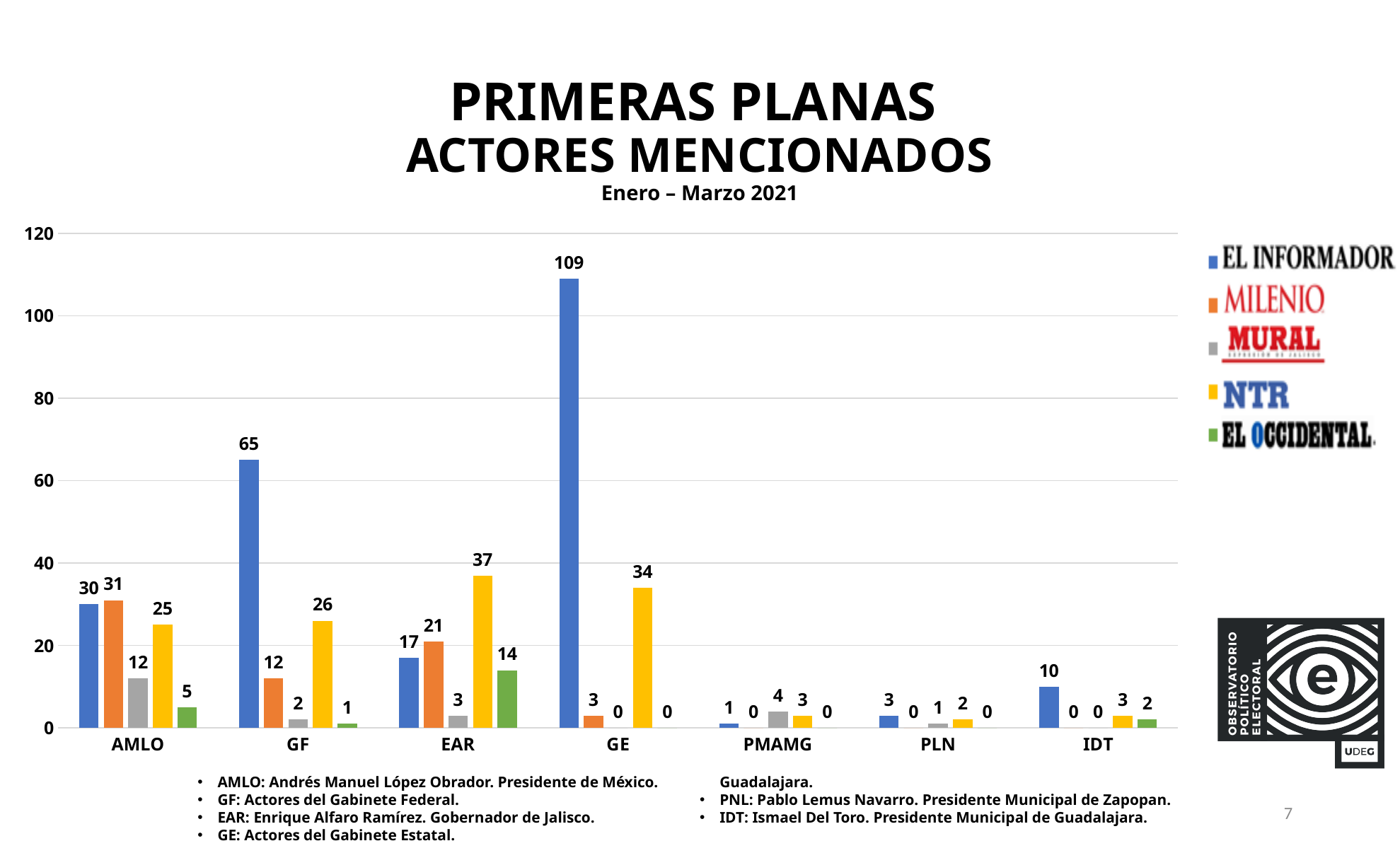
Which is larger in the EAR category: the Milenio value or the El Informador value? Milenio What kind of chart is shown on the slide? Bar chart How many categories are shown on the x axis? 7 How many series does the legend list? 5 What is the value for El Occidental in the IDT category? 2 What is the value for El Informador in the GE category? 109 What is the value for Milenio in the AMLO category? 31 What is the difference between the El Informador value for GE and the El Informador value for GF? 44 Which category has the highest El Informador value? GE Which category has the lowest NTR value? PLN Is the El Informador value for GF greater or less than 60? greater What is the value for NTR in the EAR category? 37